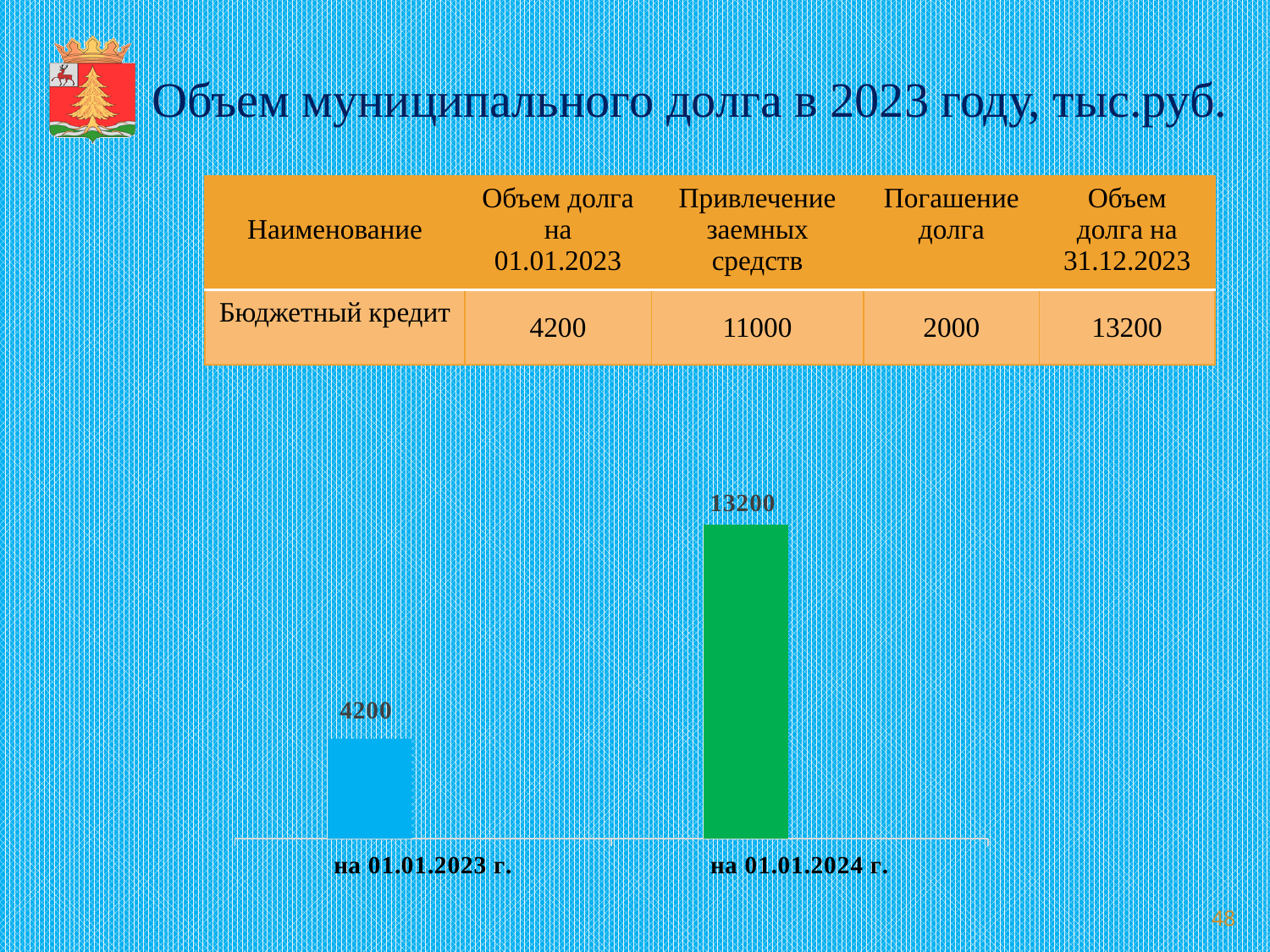
Which category has the lowest bar in the chart? на 01.01.2023 г. What is the value of the bar for "на 01.01.2023 г."? 4200 Which category has the highest bar in the chart? на 01.01.2024 г. What kind of chart is shown on the slide? bar chart What colour is the bar for "на 01.01.2024 г."? green What is the difference between the values for "на 01.01.2024 г." and "на 01.01.2023 г."? 9000 What is the value of the bar for "на 01.01.2024 г."? 13200 How many bars are shown in the chart? 2 Which is larger: the value for "на 01.01.2023 г." or the value for "на 01.01.2024 г."? на 01.01.2024 г. What colour is the bar for "на 01.01.2023 г."? blue Do the values rise or fall from "на 01.01.2023 г." to "на 01.01.2024 г."? rise